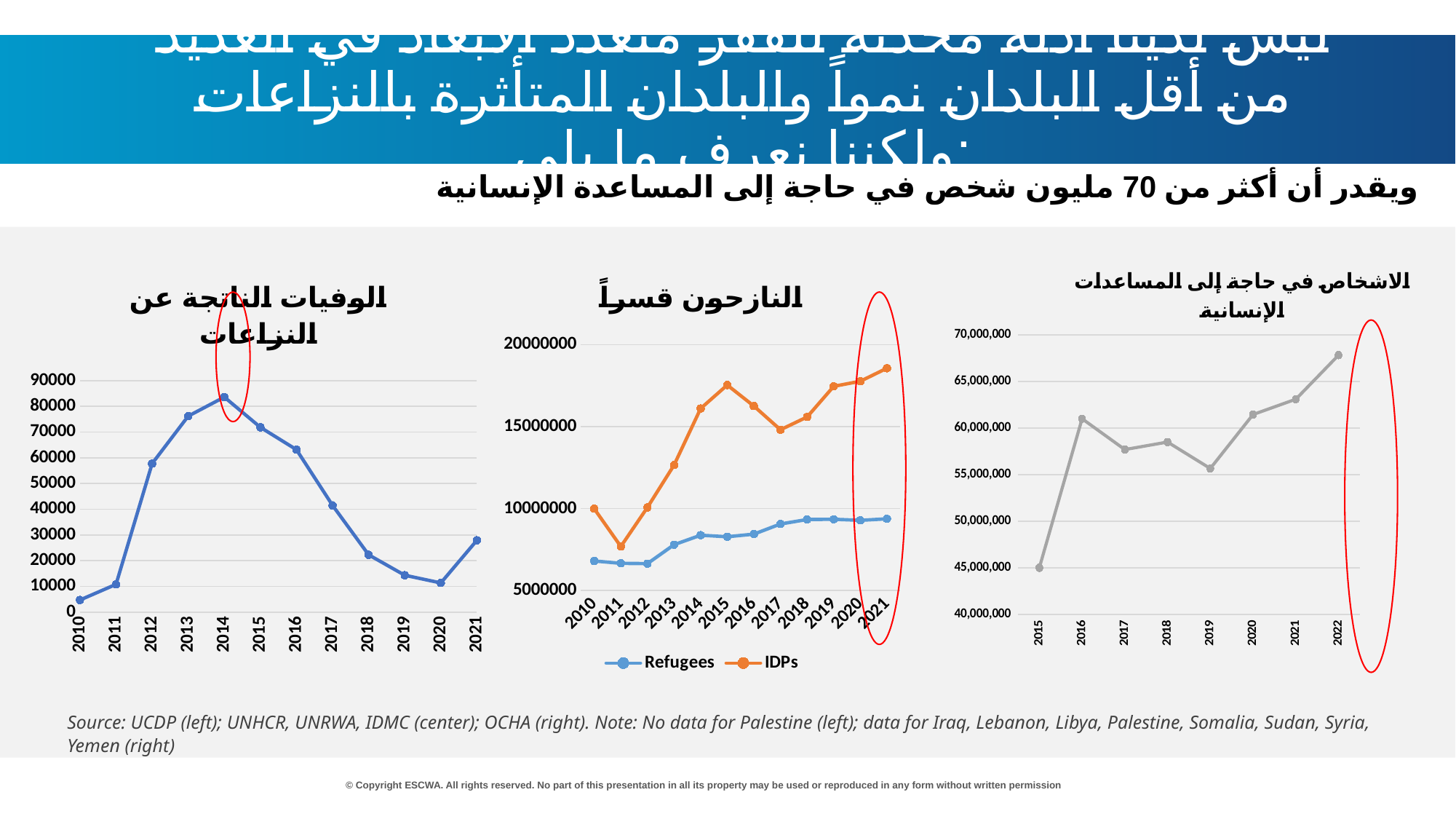
In the left chart, which year has the lowest value? 2010 In the left chart, which year has the highest value? 2014 How many years are plotted on the x axis of the left chart? 12 In the left chart, is the value for 2019 greater or less than 20000? less In the center chart, which series is higher in 2015, Refugees or IDPs? IDPs What kind of chart is the left chart on the slide? line chart In the right chart, is the value for 2022 greater or less than 65,000,000? greater In the center chart, is the IDPs value for 2021 greater or less than 15000000? greater How many series does the legend of the center chart list? 2 In the center chart, which year has the highest IDPs value? 2021 In the right chart, which year has the lowest value? 2015